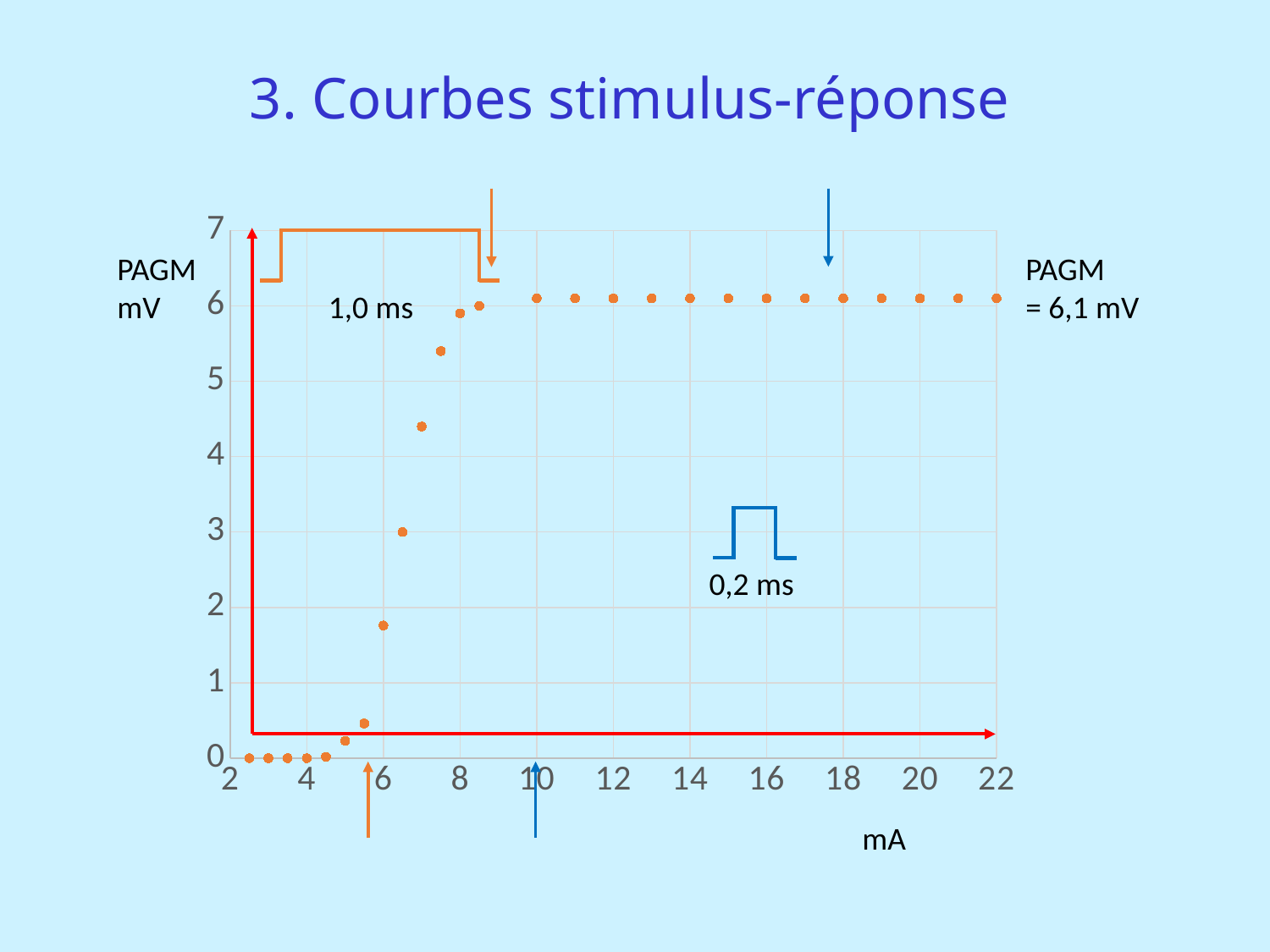
Do the plotted values rise or fall as the stimulus intensity increases from 5 mA to 9 mA? rise What is the title of the slide's chart? 3. Courbes stimulus-réponse Which is larger, the value at 6.5 mA or the value at 7.5 mA? 7.5 mA What PAGM value does the plateau of the curve reach, according to the annotation on the chart? 6,1 mV Which is larger, the value at 6 mA or the value at 8 mA? 8 mA Is the value at 6 mA greater or less than 2? less Is the value at 8 mA greater or less than 5? greater Is the value at 7 mA greater or less than 4? greater What kind of chart is shown on the slide? scatter chart What unit is shown on the x axis of the chart? mA